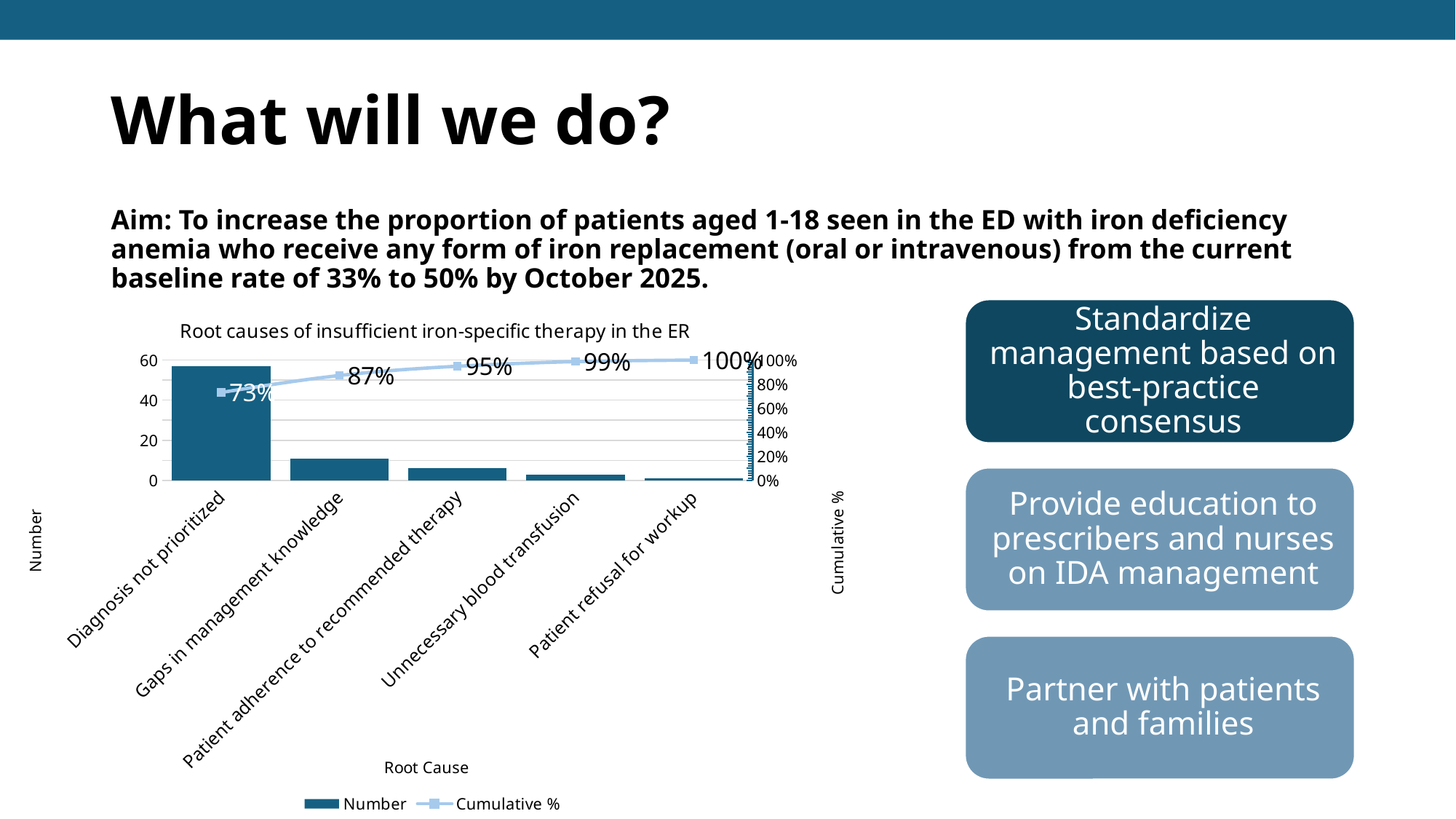
What is the cumulative % for 'Gaps in management knowledge'? 87% Which root cause has the highest Number? Diagnosis not prioritized What is the cumulative % for 'Patient adherence to recommended therapy'? 95% What is the cumulative % for 'Diagnosis not prioritized'? 73% How many series does the legend list? 2 Which root cause has the lowest Number? Patient refusal for workup Is the Number for 'Diagnosis not prioritized' greater or less than 40? greater What is the cumulative % for 'Unnecessary blood transfusion'? 99% What is the title of the chart? Root causes of insufficient iron-specific therapy in the ER Is the Number for 'Gaps in management knowledge' greater or less than 20? less By how many percentage points does the cumulative % increase from 'Diagnosis not prioritized' to 'Gaps in management knowledge'? 14 percentage points How many root cause categories are shown on the x axis? 5